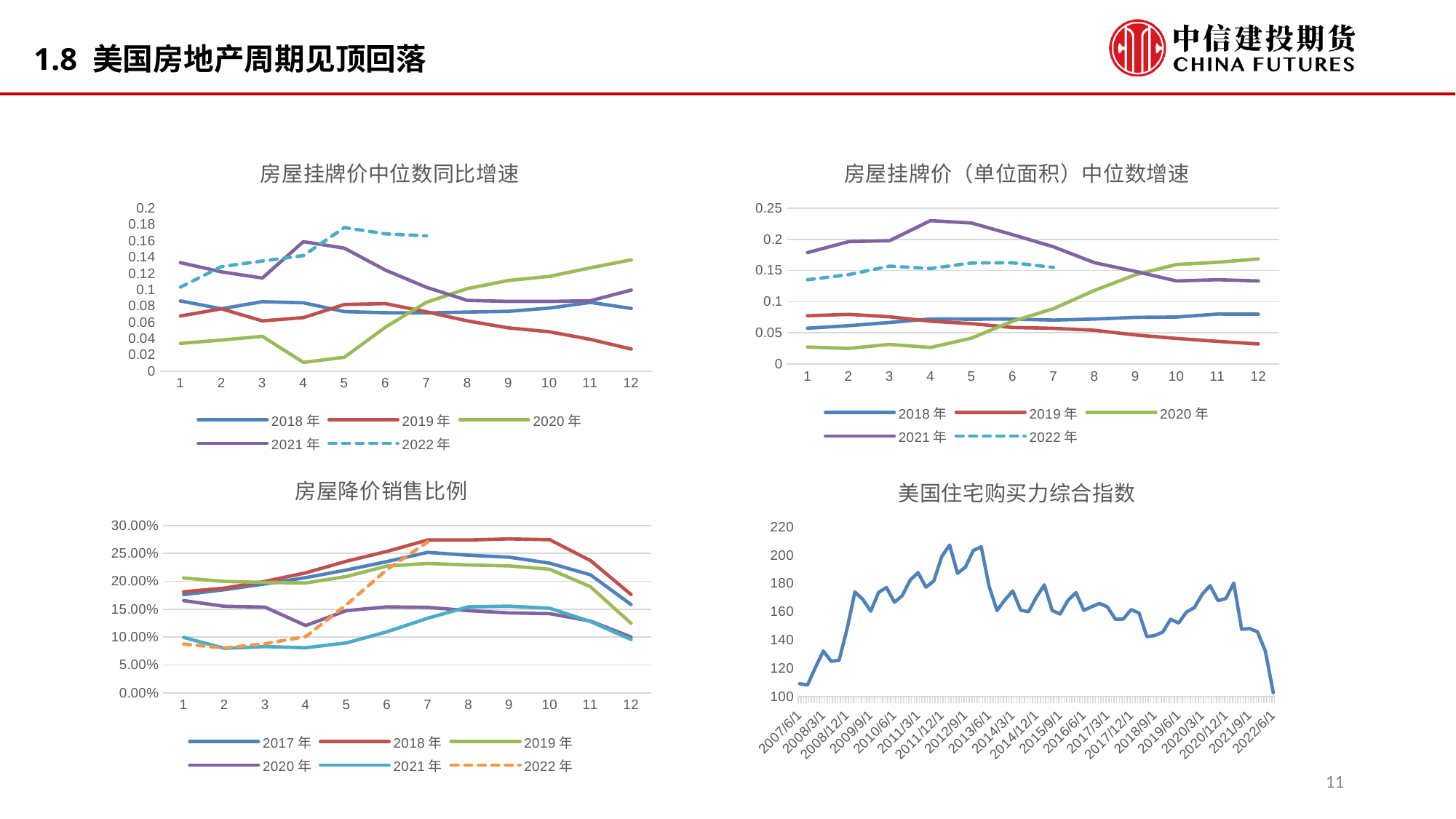
In the 房屋挂牌价中位数同比增速 chart, is the value for 2022年 at month 5 greater or less than 0.16? greater How many series does the legend of the 房屋挂牌价中位数同比增速 chart list? 5 In the 房屋挂牌价（单位面积）中位数增速 chart, is the value for 2021年 at month 4 greater or less than 0.2? greater In the 美国住宅购买力综合指数 chart, is the value at 2022/6/1 greater or less than 120? less In the 房屋降价销售比例 chart, which series is drawn as a dashed line? 2022年 How many months are shown on the x axis of the 房屋挂牌价中位数同比增速 chart? 12 In the 房屋挂牌价（单位面积）中位数增速 chart, which is larger at month 12: 2020年 or 2021年? 2020年 How many series does the legend of the 房屋降价销售比例 chart list? 6 In the 房屋挂牌价中位数同比增速 chart, does the 2019年 line rise or fall from month 5 to month 12? fall What kind of chart is the 房屋挂牌价中位数同比增速 chart? line chart In the 房屋降价销售比例 chart, does the 2022年 line rise or fall from month 1 to month 7? rise